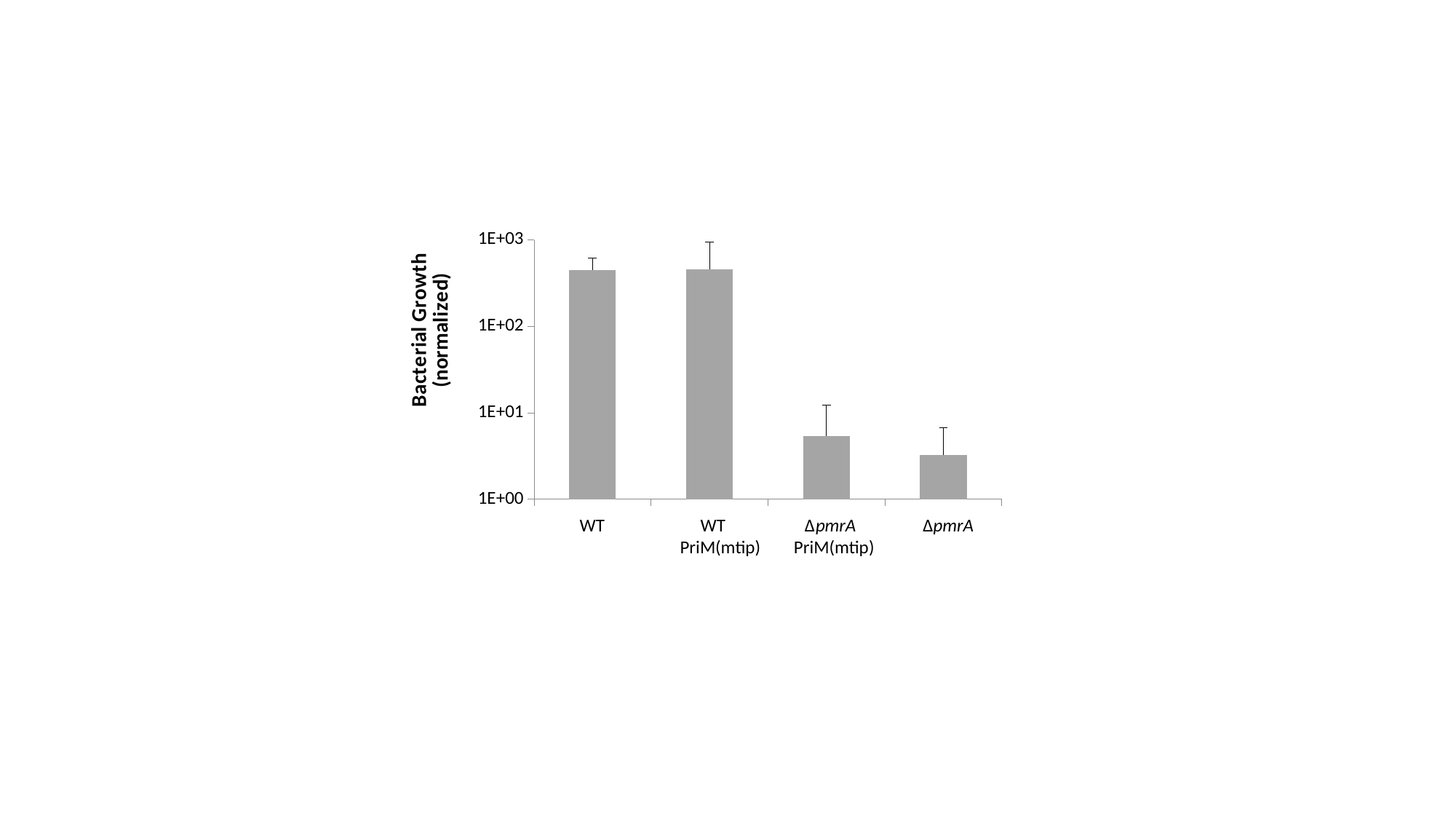
Which is larger, the value for WT or the value for ΔpmrA? WT How many categories are plotted on the x axis? 4 Which is larger, the value for WT PriM(mtip) or the value for ΔpmrA PriM(mtip)? WT PriM(mtip) What is the lowest tick label shown on the y axis? 1E+00 Which category has the lowest bacterial growth? ΔpmrA Is the value for WT greater or less than 1E+02? greater What is the title of the y axis? Bacterial Growth (normalized) Is the value for WT PriM(mtip) greater or less than 1E+03? less What kind of chart is shown on the slide? bar chart Is the value for ΔpmrA greater or less than 1E+02? less Do the bar values generally rise or fall from left to right along the x axis? fall